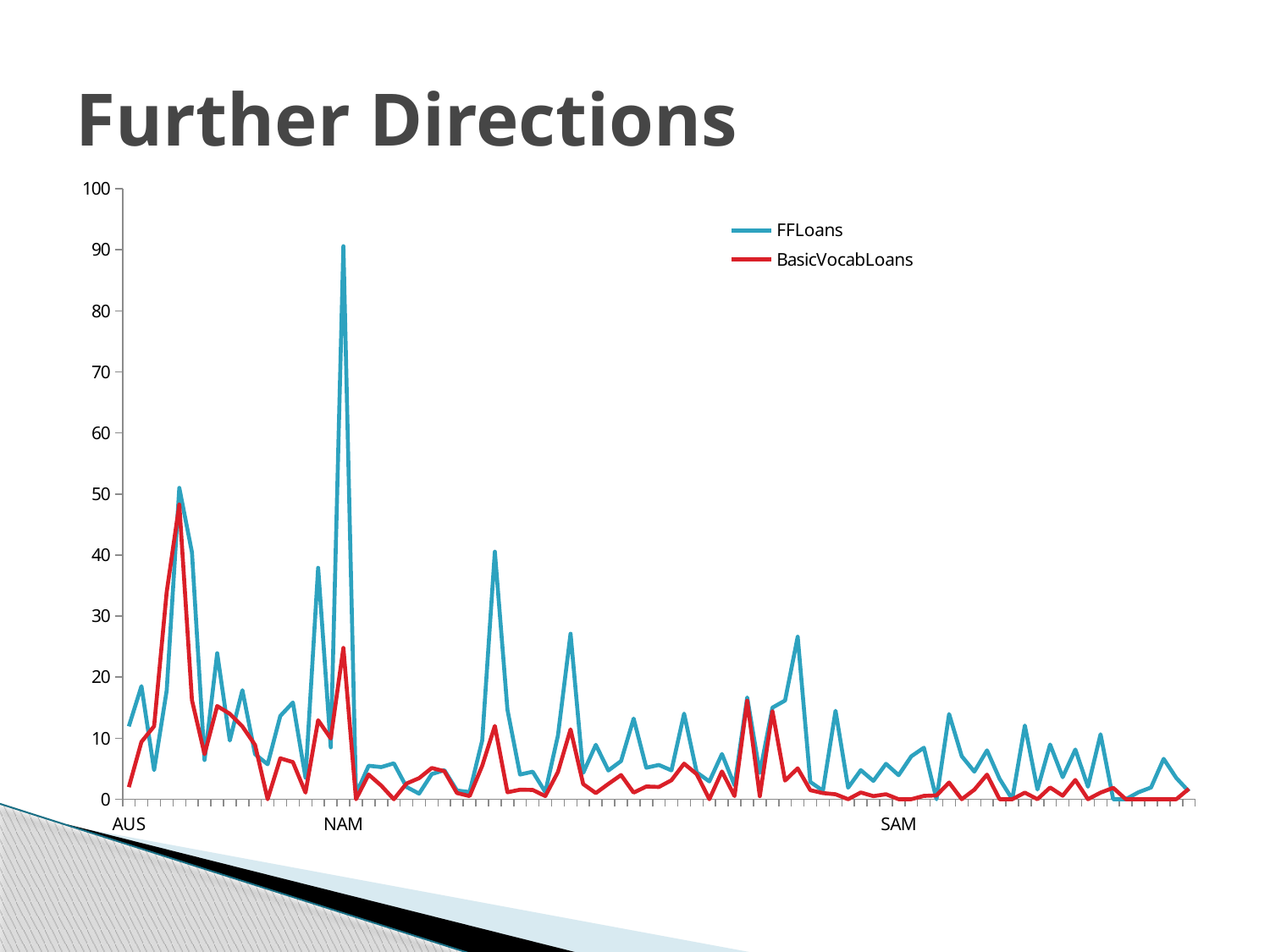
What are the two series named in the legend? FFLoans and BasicVocabLoans What colour is the FFLoans line? blue What kind of chart is shown on the slide? line chart How many region labels are shown on the x axis? 3 Do the peaks of the FFLoans line generally get larger or smaller moving from left to right along the x axis? smaller Is the highest BasicVocabLoans value greater or less than 40? greater Is the highest FFLoans value greater or less than 100? less Which series reaches the highest single value on the chart? FFLoans Is the highest FFLoans value greater or less than 80? greater How many series does the legend list? 2 Which x-axis label is the tallest spike of the FFLoans line closest to? NAM